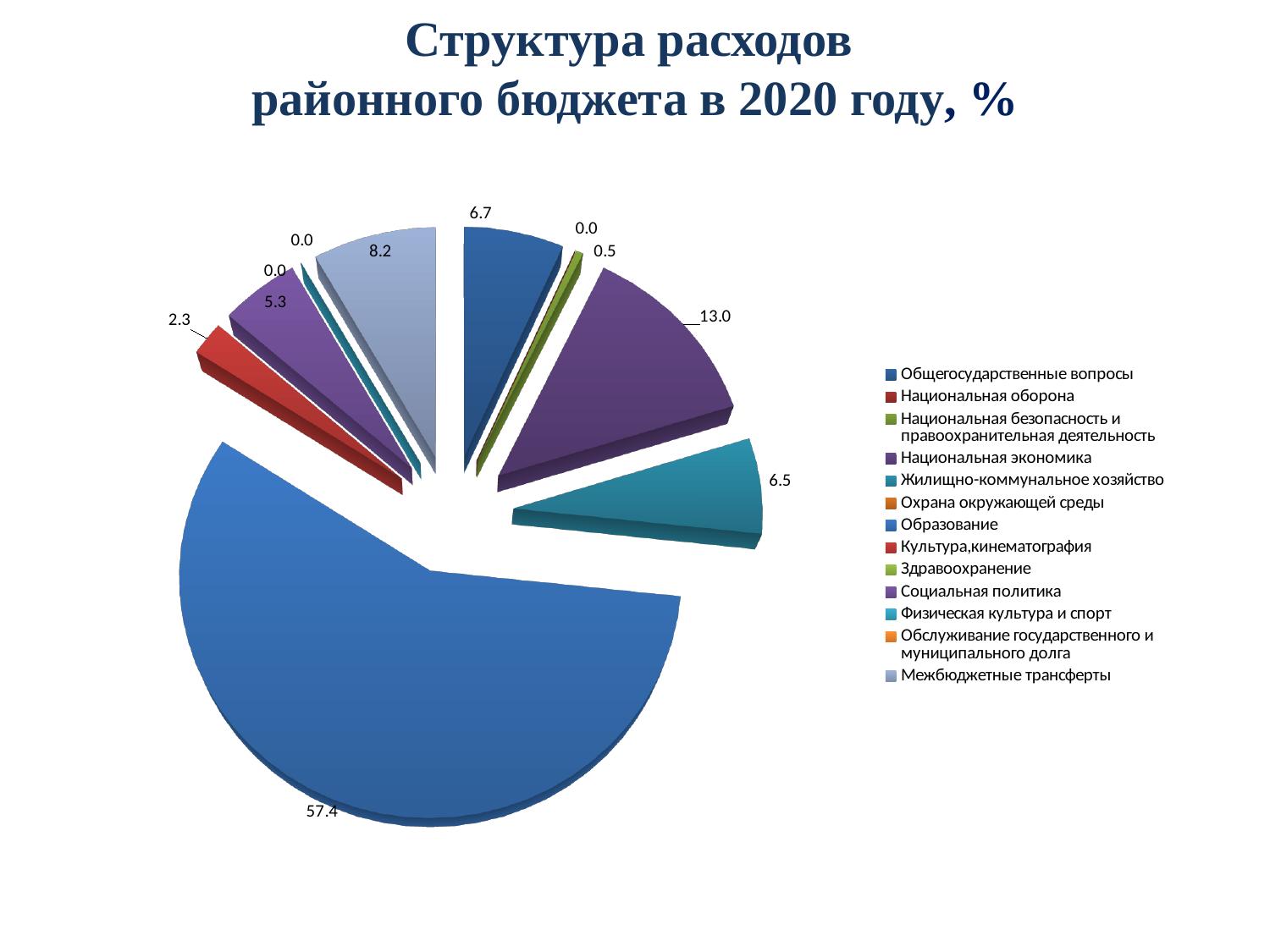
What is the value for Социальная политика? 5.3 What is the value for Образование? 57.4 Which category has the largest share of the pie? Образование What is the value for Культура,кинематография? 2.3 Which is larger, the value for Общегосударственные вопросы or the value for Жилищно-коммунальное хозяйство? Общегосударственные вопросы What is the value for Национальная экономика? 13.0 What is the value for Межбюджетные трансферты? 8.2 What is the difference between the values for Образование and Национальная экономика? 44.4 What kind of chart is shown on the slide? pie chart How many entries does the legend list? 13 What is the value for Общегосударственные вопросы? 6.7 What is the value for Жилищно-коммунальное хозяйство? 6.5